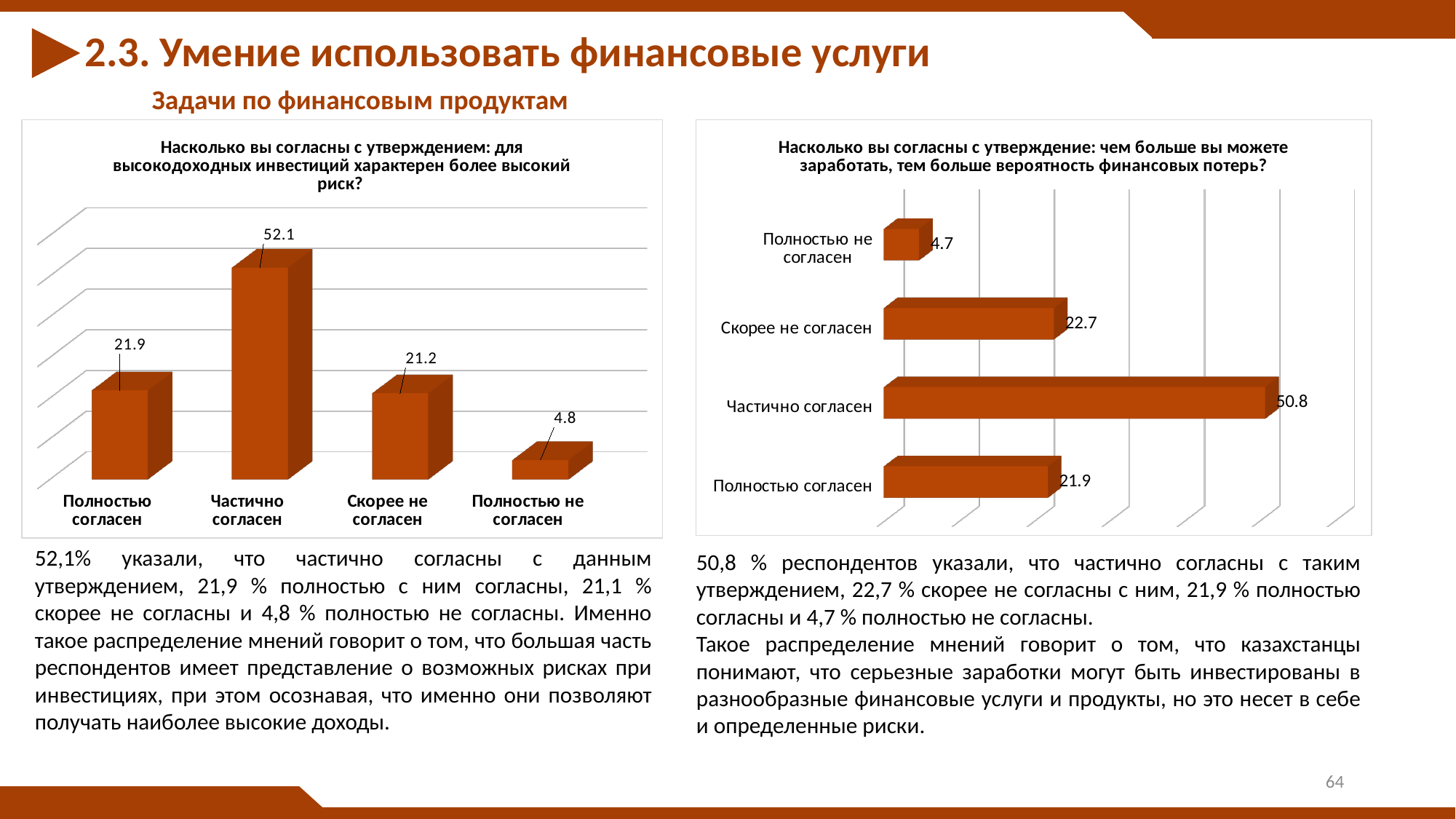
In the right chart (about earning more and probability of financial losses), which is larger: 'Скорее не согласен' or 'Полностью согласен'? Скорее не согласен In the left chart (about high-yield investments and higher risk), what is the value for 'Полностью не согласен'? 4.8 What type of chart is the left chart (about high-yield investments and higher risk)? Bar chart In the right chart (about earning more and probability of financial losses), what is the difference between 'Частично согласен' and 'Полностью согласен'? 28.9 In the right chart (about earning more and probability of financial losses), which category has the lowest value? Полностью не согласен What type of chart is the right chart (about earning more and probability of financial losses)? Bar chart In the right chart (about earning more and probability of financial losses), what is the value for 'Частично согласен'? 50.8 In the left chart (about high-yield investments and higher risk), what is the value for 'Частично согласен'? 52.1 In the left chart (about high-yield investments and higher risk), how many categories are shown? 4 In the left chart (about high-yield investments and higher risk), which category has the highest value? Частично согласен In the right chart (about earning more and probability of financial losses), what is the value for 'Скорее не согласен'? 22.7 In the left chart (about high-yield investments and higher risk), what is the difference between 'Полностью согласен' and 'Скорее не согласен'? 0.7